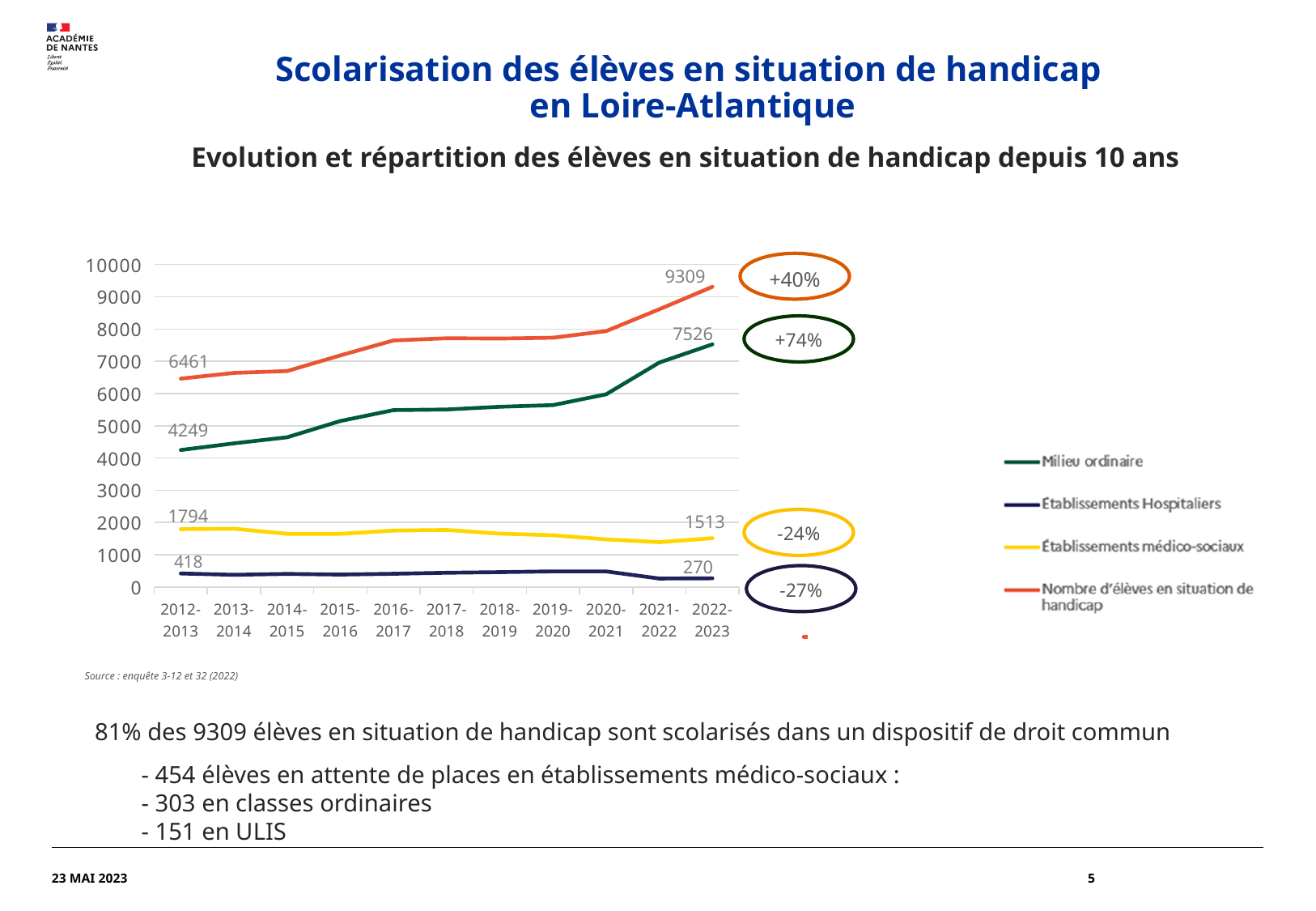
What is the difference between "Milieu ordinaire" in 2022-2023 and in 2012-2013? 3277 How many school years are shown on the x axis? 11 How many series does the legend list? 4 What is the value of "Milieu ordinaire" in 2012-2013? 4249 What is the value of "Établissements médico-sociaux" in 2022-2023? 1513 By how much did "Nombre d'élèves en situation de handicap" increase from 2012-2013 to 2022-2023? 2848 What is the value of "Établissements Hospitaliers" in 2012-2013? 418 Which series has the lowest value in 2022-2023? Établissements Hospitaliers What type of chart is shown on the slide? line chart Does the "Établissements Hospitaliers" series rise or fall between 2012-2013 and 2022-2023? fall Is the value for "Milieu ordinaire" in 2016-2017 greater or less than 5000? greater What is the value of "Nombre d'élèves en situation de handicap" in 2022-2023? 9309